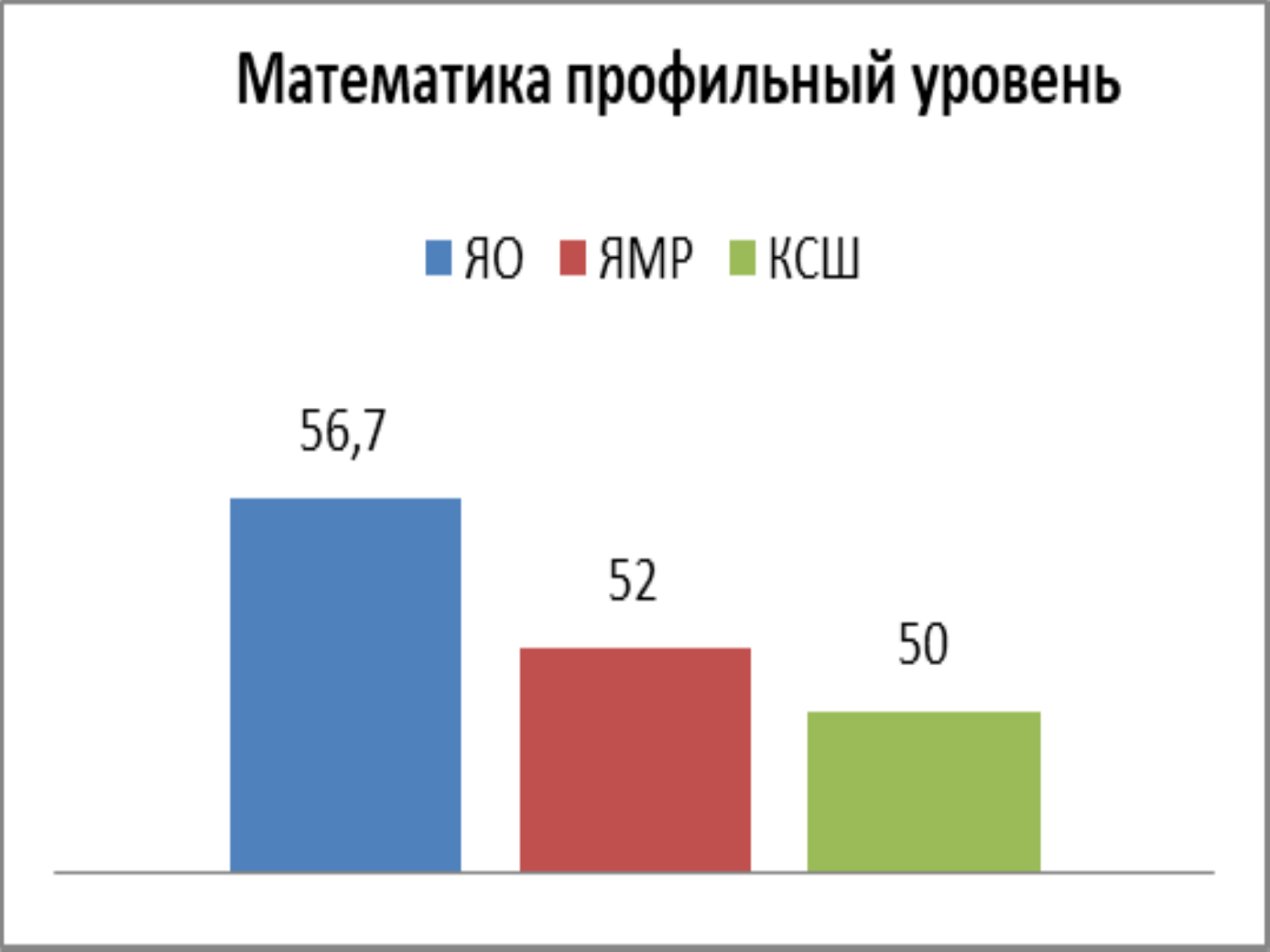
What kind of chart is shown? bar chart How many bars are plotted on the chart? 3 Which series has the highest value? ЯО What is the value for ЯО? 56,7 How many series does the legend list? 3 What is the difference between the values for ЯМР and КСШ? 2 Which series has the lowest value? КСШ What is the value for КСШ? 50 What is the title of the chart? Математика профильный уровень Which is larger, the value for ЯО or the value for КСШ? ЯО What is the difference between the values for ЯО and ЯМР? 4,7 What is the value for ЯМР? 52